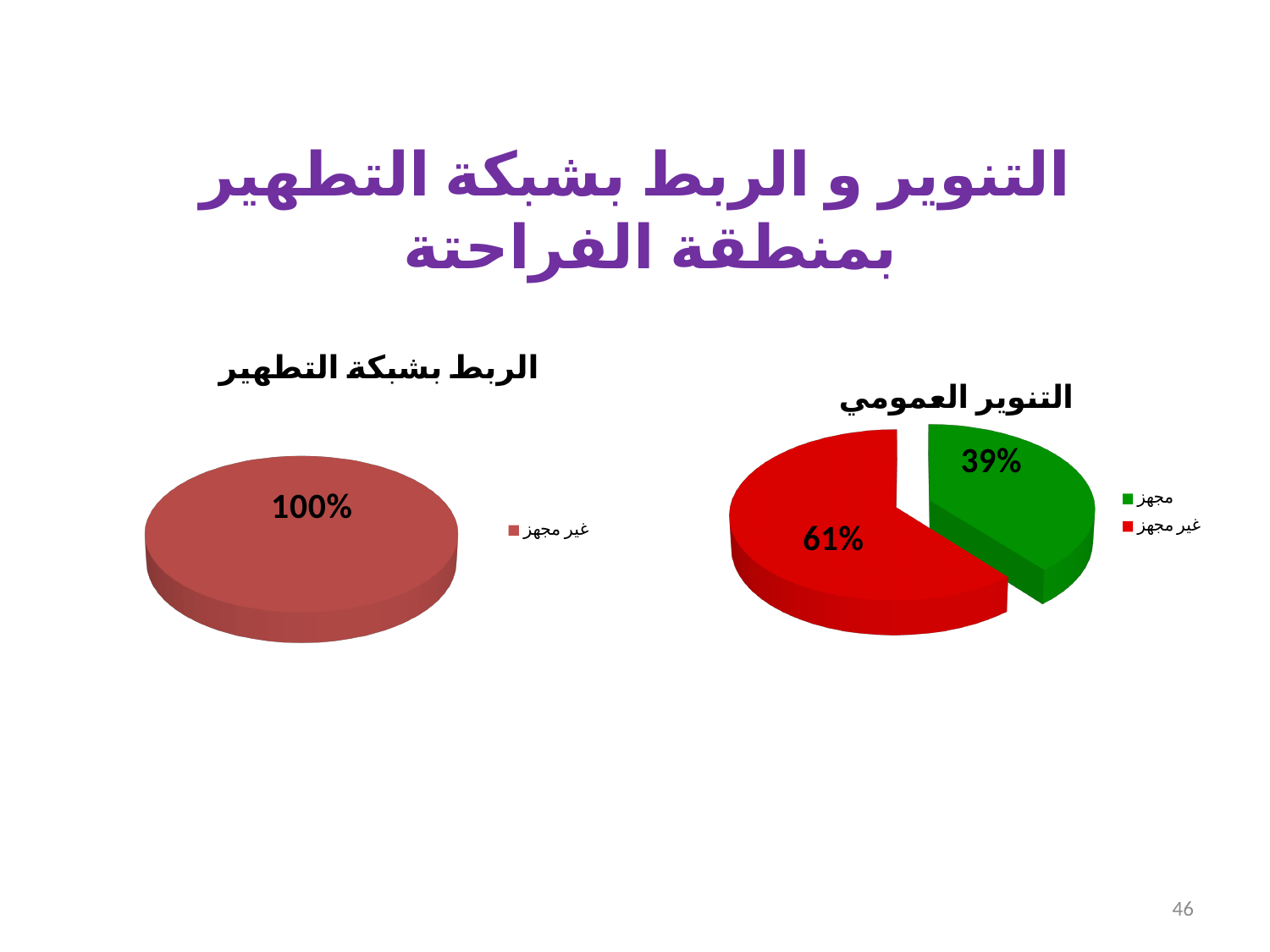
How many entries does the legend of the chart titled "التنوير العمومي" list? 2 In the chart titled "التنوير العمومي", what share does "غير مجهز" have? 61% In the chart titled "التنوير العمومي", which is larger: "مجهز" or "غير مجهز"? غير مجهز How many slices does the chart titled "التنوير العمومي" have? 2 In the chart titled "التنوير العمومي", what colour is the "مجهز" slice? Green In the chart titled "الربط بشبكة التطهير", what value is shown for "غير مجهز"? 100% How many slices does the chart titled "الربط بشبكة التطهير" have? 1 What type of chart is the chart titled "الربط بشبكة التطهير"? Pie chart In the chart titled "التنوير العمومي", which category has the largest slice? غير مجهز In the chart titled "التنوير العمومي", which category has the smallest slice? مجهز In the chart titled "التنوير العمومي", what share does "مجهز" have? 39% In the chart titled "التنوير العمومي", what is the difference between the "غير مجهز" and "مجهز" shares? 22%